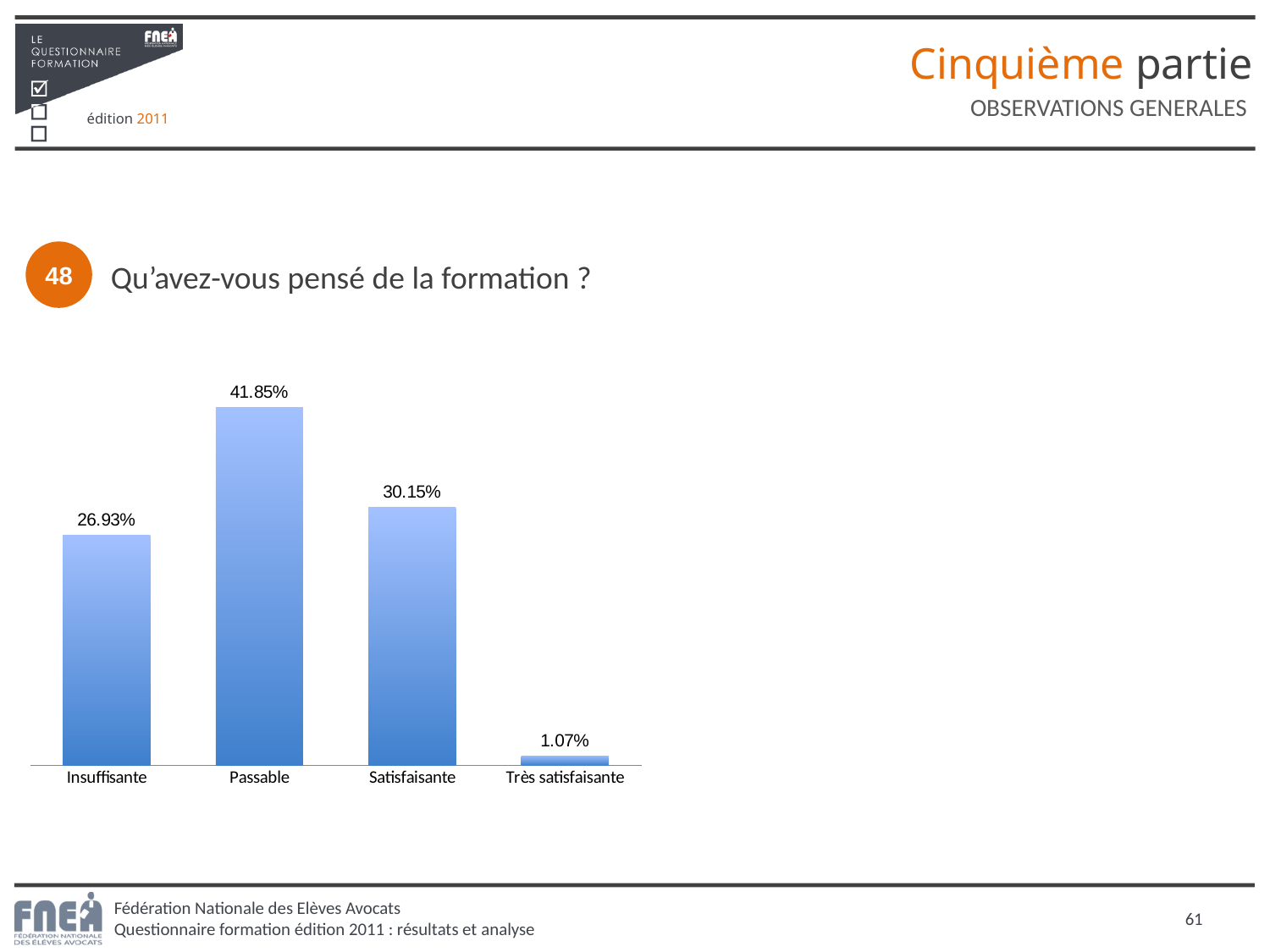
What is the value for Passable? 41.85% What is the value for Insuffisante? 26.93% What is the value for Très satisfaisante? 1.07% What is the difference between the values for Passable and Satisfaisante? 11.70% Which is larger, the value for Insuffisante or the value for Satisfaisante? Satisfaisante Which category has the lowest value? Très satisfaisante What is the value for Satisfaisante? 30.15% How many categories are shown on the chart? 4 What question does the chart on the slide answer? Qu'avez-vous pensé de la formation ? What is the difference between the values for Satisfaisante and Insuffisante? 3.22% Which category has the highest value? Passable What kind of chart is shown on the slide? Bar chart